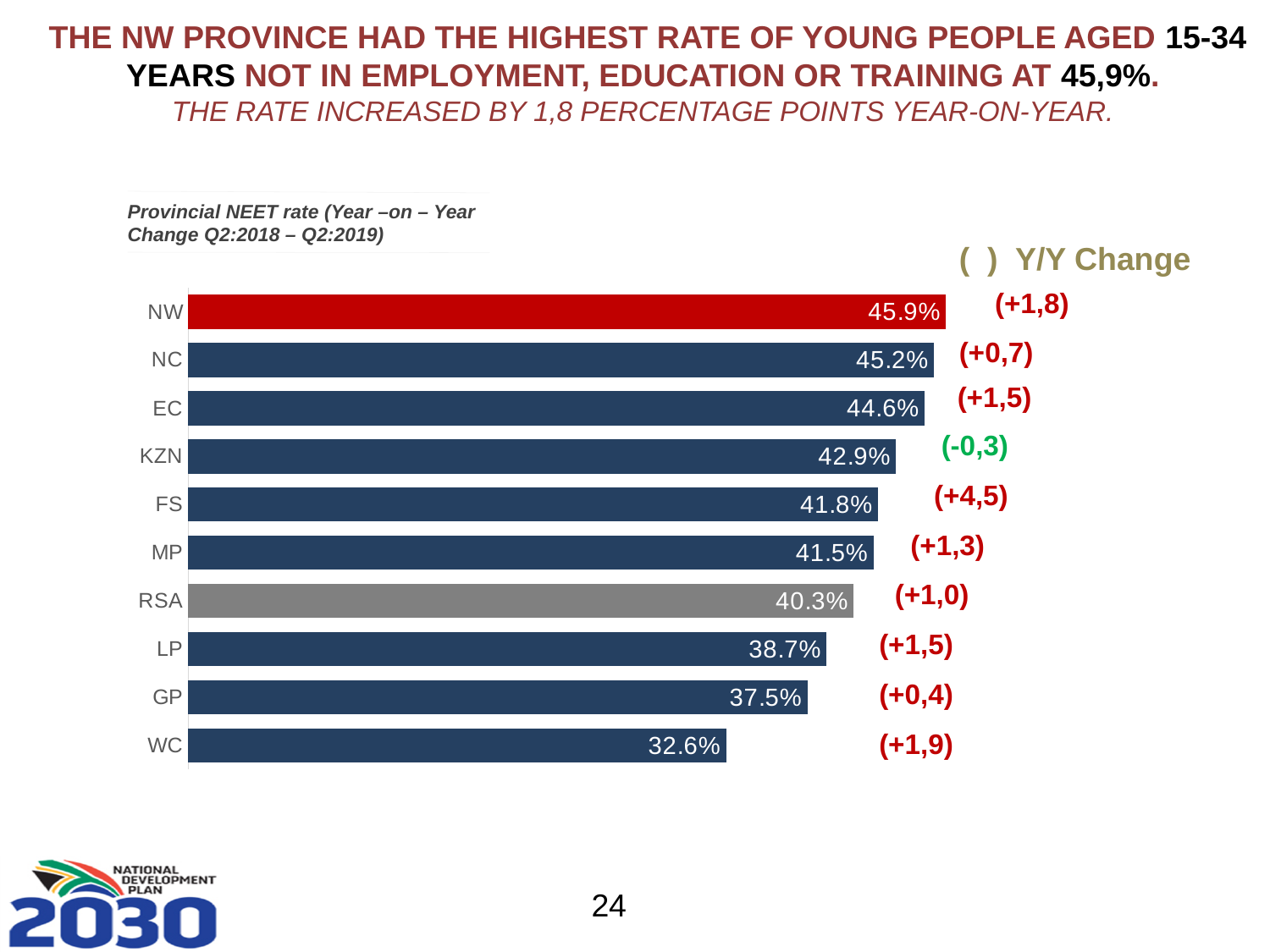
What is the NEET rate for NW? 45.9% Which province has the highest NEET rate? NW Which has a higher NEET rate, GP or LP? LP What is the NEET rate for RSA? 40.3% What is the NEET rate for WC? 32.6% What is the year-on-year change shown for FS? (+4,5) What kind of chart is shown on the slide? Bar chart What is the difference between the NEET rates of NW and WC? 13.3 percentage points Which category has the lowest NEET rate? WC How many bars are shown in the chart? 10 What is the difference between the NEET rates of KZN and FS? 1.1 percentage points Which bar is coloured red in the chart? NW